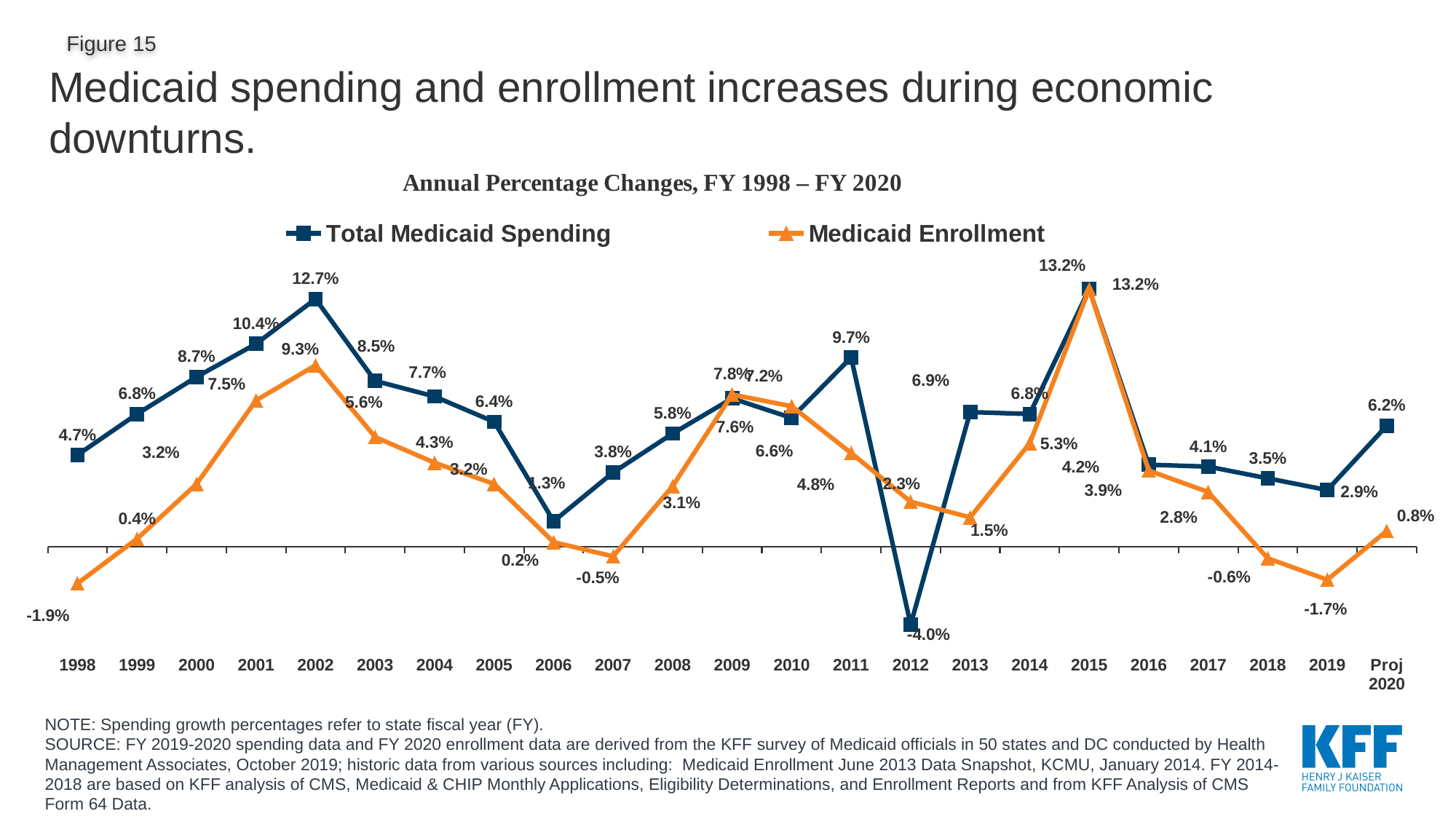
How many years (including Proj 2020) are shown on the x axis? 23 How many series does the legend list? 2 What was the annual percentage change in Medicaid Enrollment in 1998? -1.9% What is the subtitle of the chart? Annual Percentage Changes, FY 1998 – FY 2020 What is the difference between the Total Medicaid Spending change in 2011 (9.7%) and the Medicaid Enrollment change in 2011 (4.8%)? 4.9 percentage points Which series had the larger annual percentage change in 2013, Total Medicaid Spending or Medicaid Enrollment? Total Medicaid Spending In which year was the annual percentage change in Medicaid Enrollment highest? 2015 What was the annual percentage change in Total Medicaid Spending in 2002? 12.7% What kind of chart is shown on the slide? Line chart Did the annual percentage change in Total Medicaid Spending rise or fall from 2016 to 2019? Fall What is the projected annual percentage change in Total Medicaid Spending for Proj 2020? 6.2% In which year was the annual percentage change in Total Medicaid Spending lowest? 2012